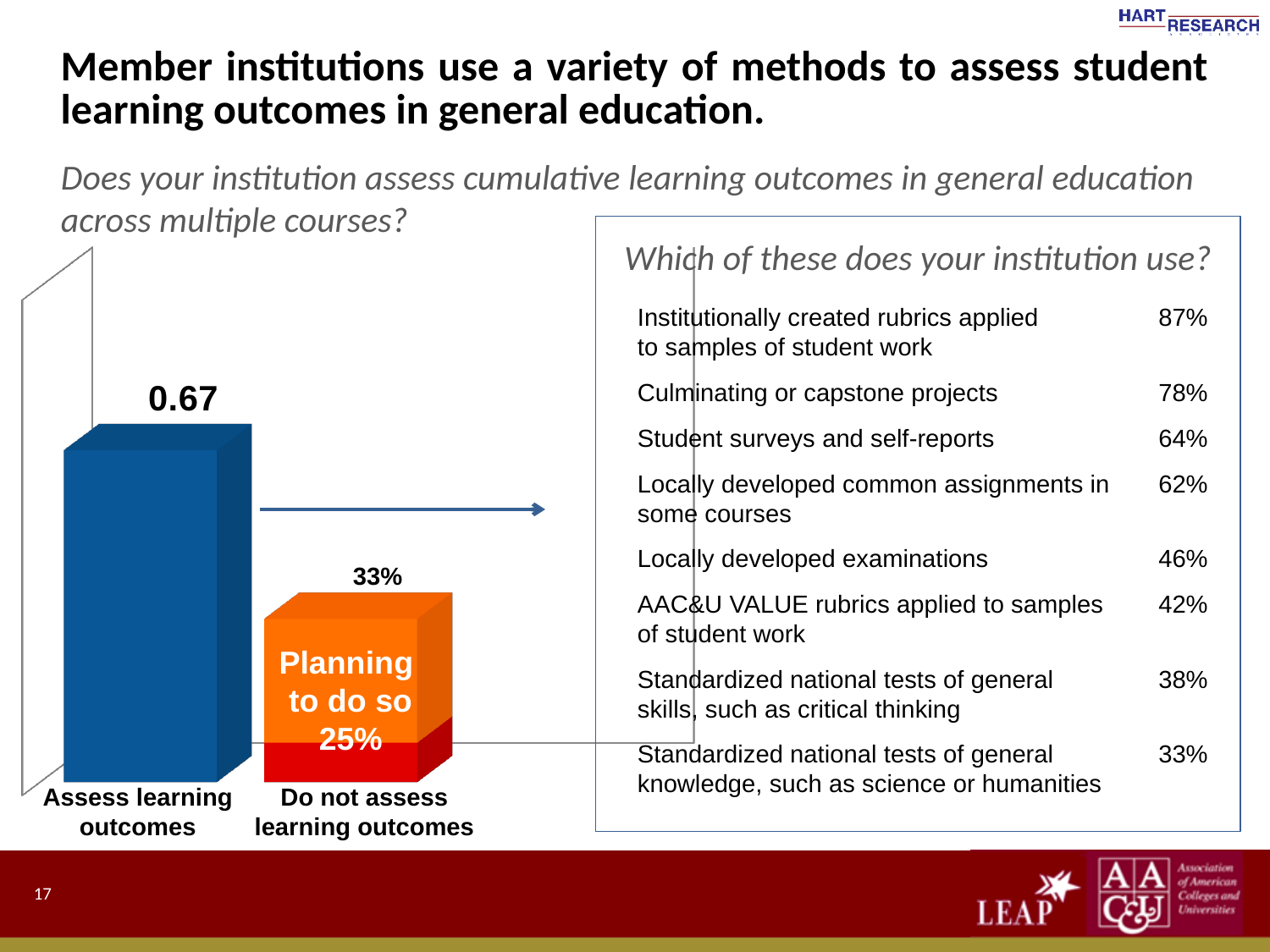
What value is shown above the Do not assess learning outcomes bar? 33% What kind of chart is shown on the left of the slide? Bar chart What is the total of the stacked Do not assess learning outcomes bar? 33% Which category has the tallest bar? Assess learning outcomes What is the difference between the total for Do not assess learning outcomes (33%) and the Planning to do so portion (25%)? 8% Which category has the shortest bar? Do not assess learning outcomes Which is larger, the bar for Assess learning outcomes or the bar for Do not assess learning outcomes? Assess learning outcomes What text is written inside the orange segment of the Do not assess learning outcomes bar? Planning to do so What percentage is labelled for the Planning to do so portion of the Do not assess learning outcomes bar? 25% What value is shown for the Assess learning outcomes bar? 0.67 How many categories are shown on the bar chart? 2 What colour is the Assess learning outcomes bar? Blue